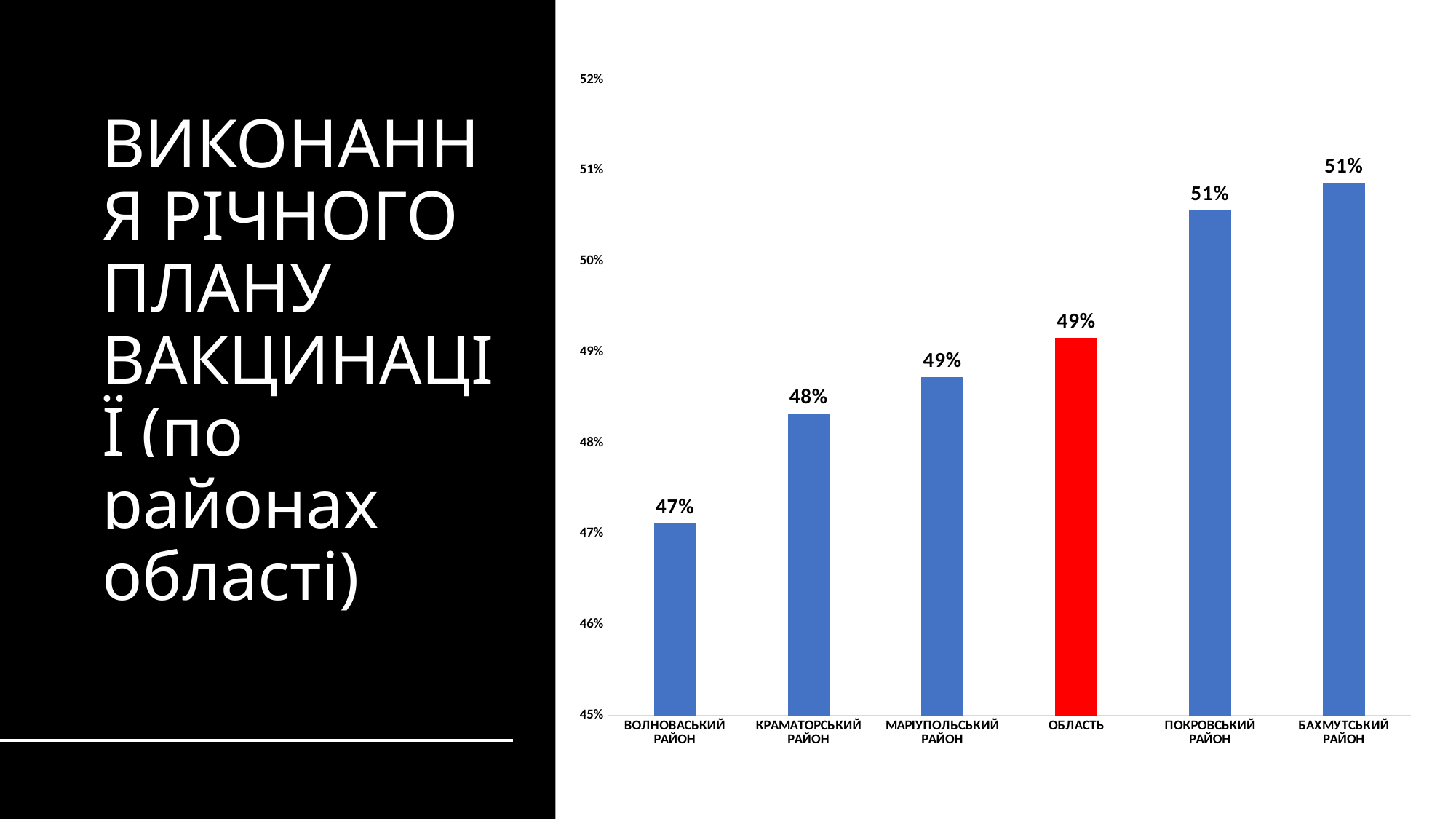
What kind of chart is shown on the slide? bar chart Which category has the lowest value? Волноваський район Is the value for Волноваський район greater or less than 48%? less Which category's bar is coloured red? Область What is the value for Волноваський район? 47% Is the value for Бахмутський район greater or less than 50%? greater What is the value for Покровський район? 51% What is the value for Краматорський район? 48% How many categories are shown on the chart? 6 What is the difference between the values for Бахмутський район and Волноваський район? 4% What is the value for Область? 49% Which is larger, the value for Покровський район or Краматорський район? Покровський район